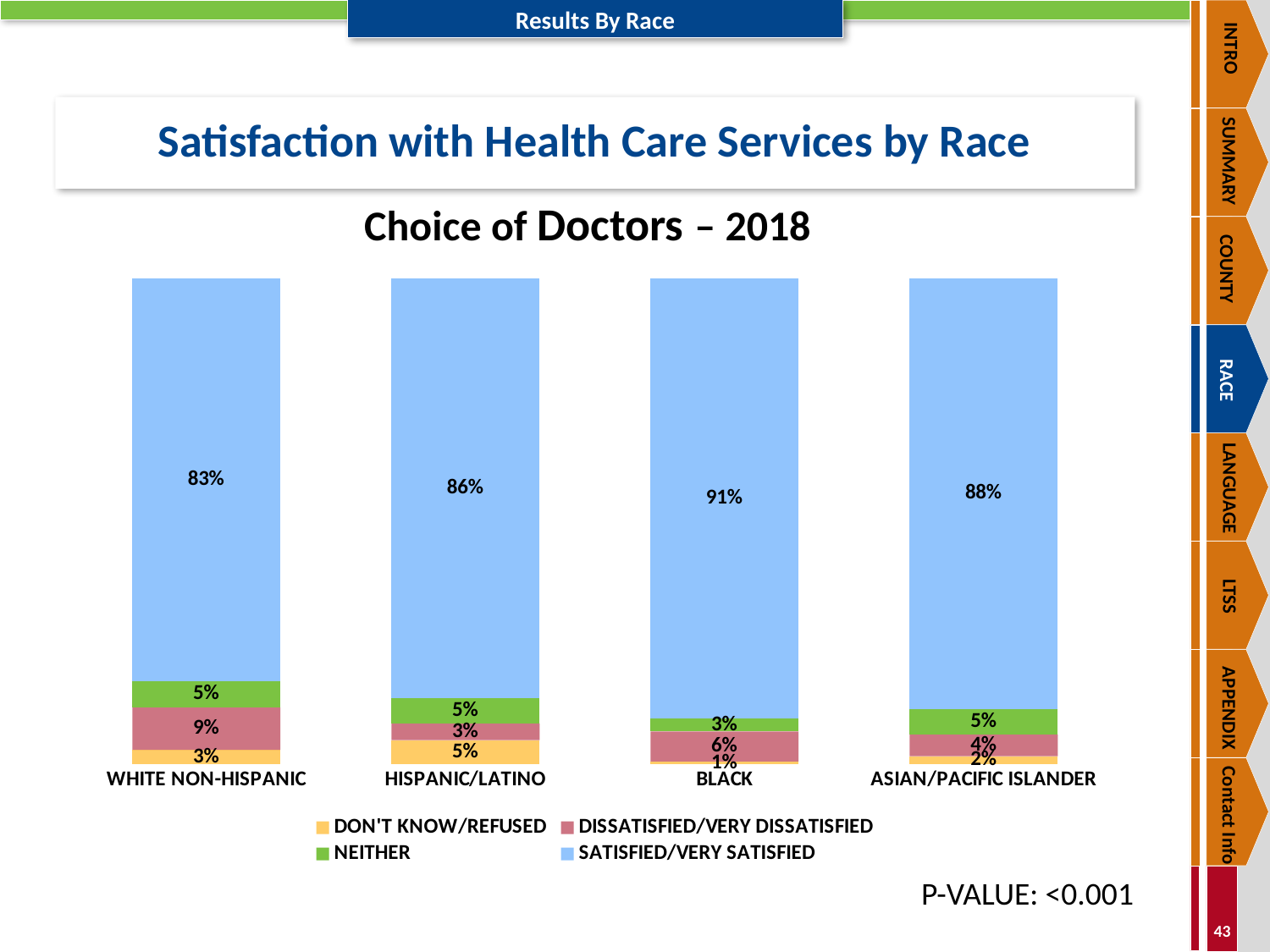
What is the Dissatisfied/Very Dissatisfied value for White Non-Hispanic? 9% Which race group has the lowest Satisfied/Very Satisfied value? White Non-Hispanic What is the Neither value for Asian/Pacific Islander? 5% Which is larger, the Dissatisfied/Very Dissatisfied value for White Non-Hispanic or for Black? White Non-Hispanic What is the title of the chart? Choice of Doctors – 2018 What kind of chart is shown on the slide? Stacked bar chart How many series does the legend list? 4 What is the Don't Know/Refused value for Hispanic/Latino? 5% Which race group has the highest Satisfied/Very Satisfied value? Black What is the difference between the Satisfied/Very Satisfied values for Asian/Pacific Islander and White Non-Hispanic? 5% What is the Satisfied/Very Satisfied value for Black? 91% How many race groups are shown on the x axis? 4